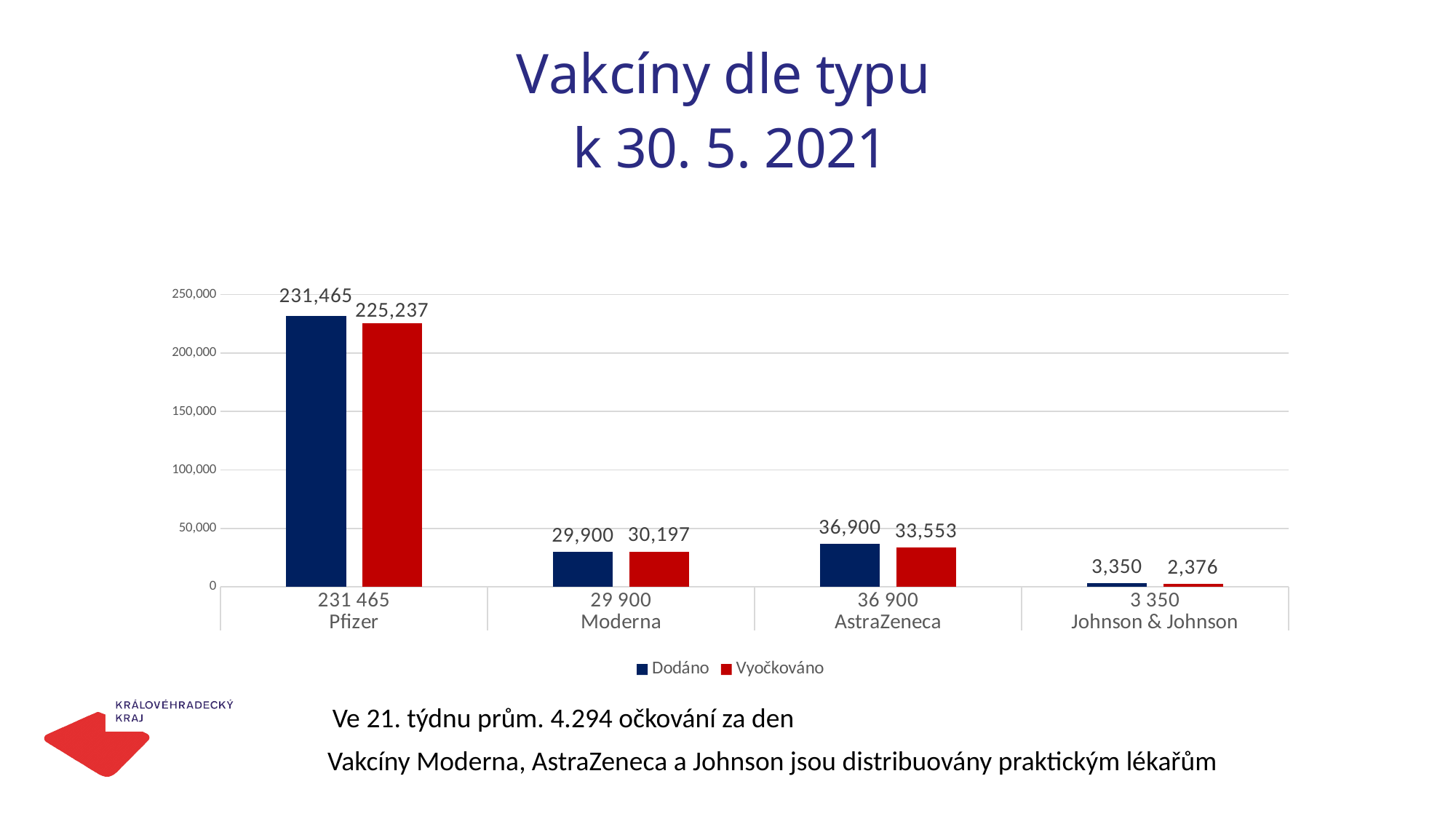
Which vaccine has the lowest Vyočkováno value? Johnson & Johnson What kind of chart is shown on the slide? Bar chart Which vaccine has the highest Dodáno value? Pfizer How many vaccine types are shown on the x axis? 4 What is the difference between the Dodáno and Vyočkováno values for Pfizer? 6,228 What is the Dodáno value for Johnson & Johnson? 3,350 What is the Vyočkováno value for AstraZeneca? 33,553 What is the difference between the Dodáno values for AstraZeneca and Moderna? 7,000 How many series does the legend list? 2 What is the Dodáno value for Pfizer? 231,465 What is the Vyočkováno value for Moderna? 30,197 Which is larger for AstraZeneca, the Dodáno value or the Vyočkováno value? Dodáno